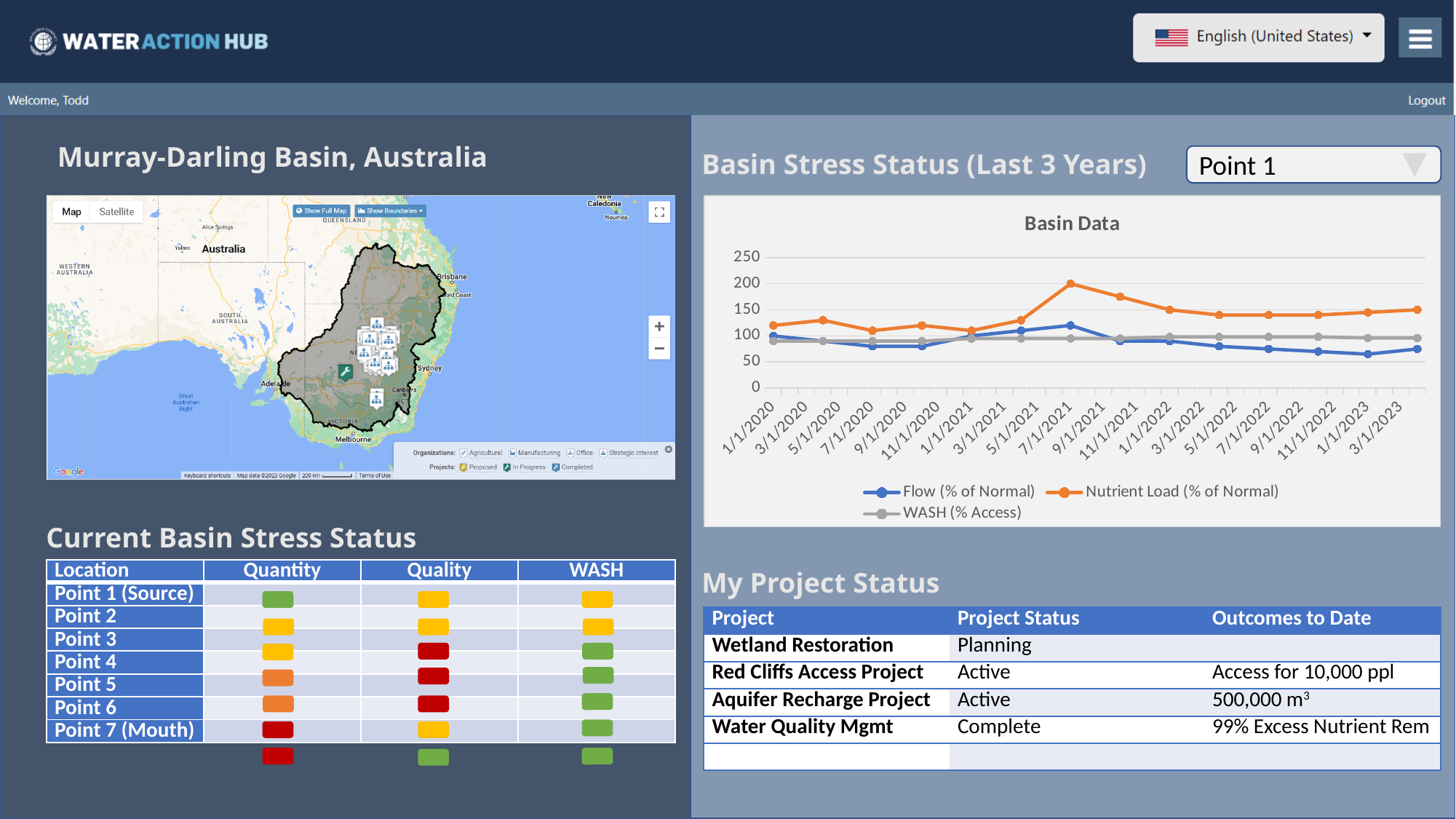
In the Basin Data chart, which series has the higher value on 3/1/2023: Flow (% of Normal) or Nutrient Load (% of Normal)? Nutrient Load (% of Normal) In the Basin Data chart, is the Nutrient Load (% of Normal) value on 7/1/2021 greater or less than 150? greater What colour is the Nutrient Load (% of Normal) line in the Basin Data chart? orange In the Basin Data chart, is the Nutrient Load (% of Normal) value on 3/1/2023 greater or less than 100? greater How many series does the legend of the Basin Data chart list? 3 On which date does Nutrient Load (% of Normal) reach its highest value in the Basin Data chart? 7/1/2021 In the Basin Data chart, does Flow (% of Normal) rise or fall from 7/1/2021 to 1/1/2023? fall How many dates are shown along the x axis of the Basin Data chart? 20 In the Basin Data chart, is the WASH (% Access) value on 1/1/2020 greater or less than 100? less What kind of chart is the Basin Data chart? line chart What is the title of the chart under Basin Stress Status (Last 3 Years)? Basin Data